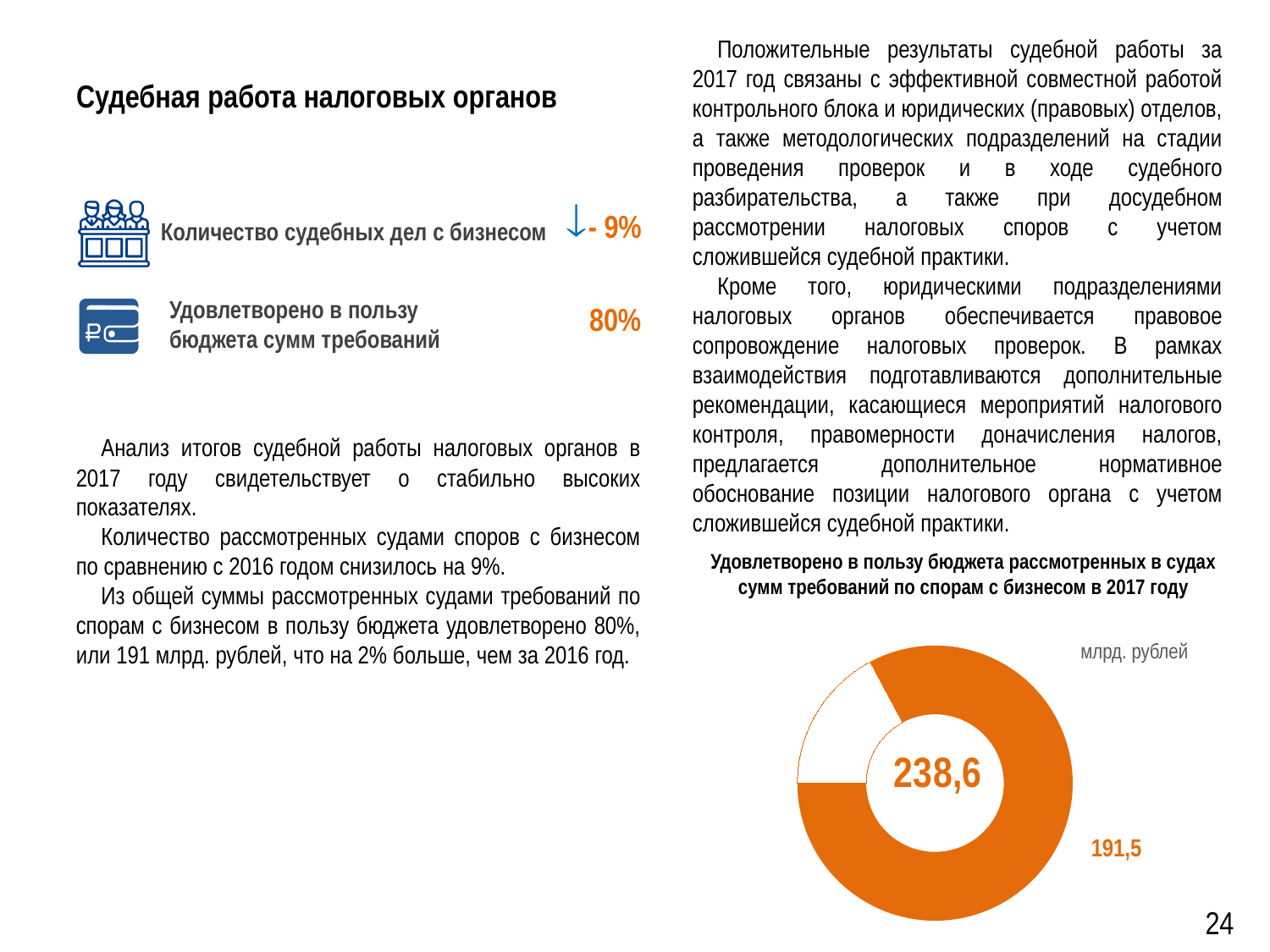
What is the difference between the centre value 238,6 and the orange segment value 191,5 in the donut chart? 47,1 In what units are the values of the donut chart given? млрд. рублей How many segments does the donut chart have? 2 What value is labelled on the orange segment of the donut chart? 191,5 What value is printed in the centre of the donut chart? 238,6 What is the title of the chart on the slide? Удовлетворено в пользу бюджета рассмотренных в судах сумм требований по спорам с бизнесом в 2017 году Is the value of the orange segment in the donut chart greater or less than 200? less What kind of chart is shown on the slide? Donut (pie) chart Which segment of the donut chart is larger, the orange one or the white one? The orange one What share of the total 238,6 does the orange segment (191,5) represent in the donut chart? 80%